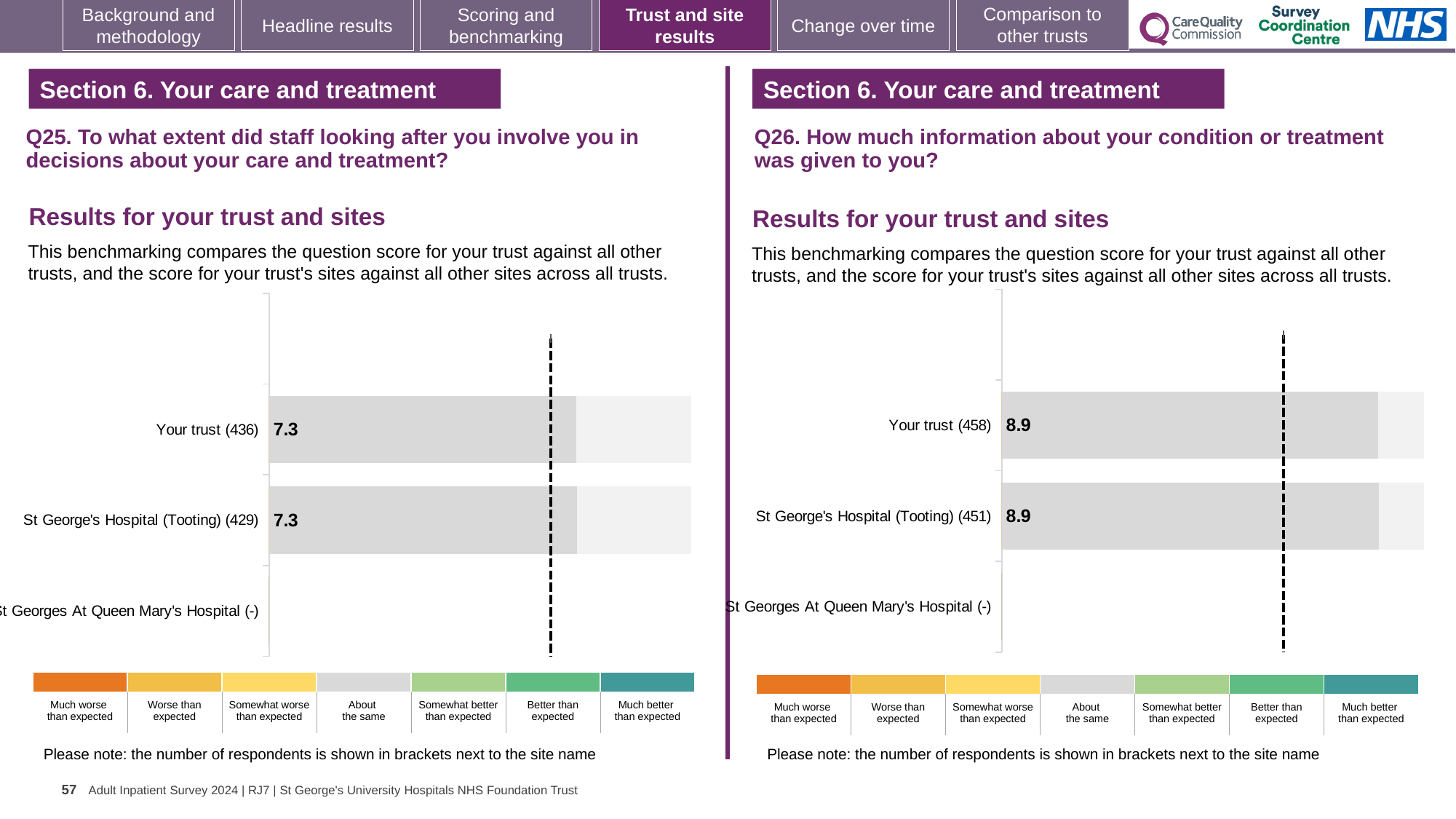
What kind of chart is used on the Q25 chart (left)? Bar chart On the Q26 chart (right), what is the score for St George's Hospital (Tooting) (451)? 8.9 On the Q26 chart (right), what is the difference between the score for Your trust and the score for St George's Hospital (Tooting)? 0 Is the score for Your trust on the Q26 chart (right) larger or smaller than the score for Your trust on the Q25 chart (left)? Larger On the Q25 chart (left), what is the score for Your trust (436)? 7.3 On the Q26 chart (right), what is the score for Your trust (458)? 8.9 On the Q26 chart (right), how many site/trust categories are listed on the vertical axis? 3 On the Q25 chart (left), what is the difference between the score for Your trust and the score for St George's Hospital (Tooting)? 0 On the Q25 chart (left), how many site/trust categories are listed on the vertical axis? 3 On the Q26 chart (right), how many respondents are shown in brackets for Your trust? 458 On the Q25 chart (left), which category has no score shown? St Georges At Queen Mary's Hospital (-) On the Q25 chart (left), what is the score for St George's Hospital (Tooting) (429)? 7.3